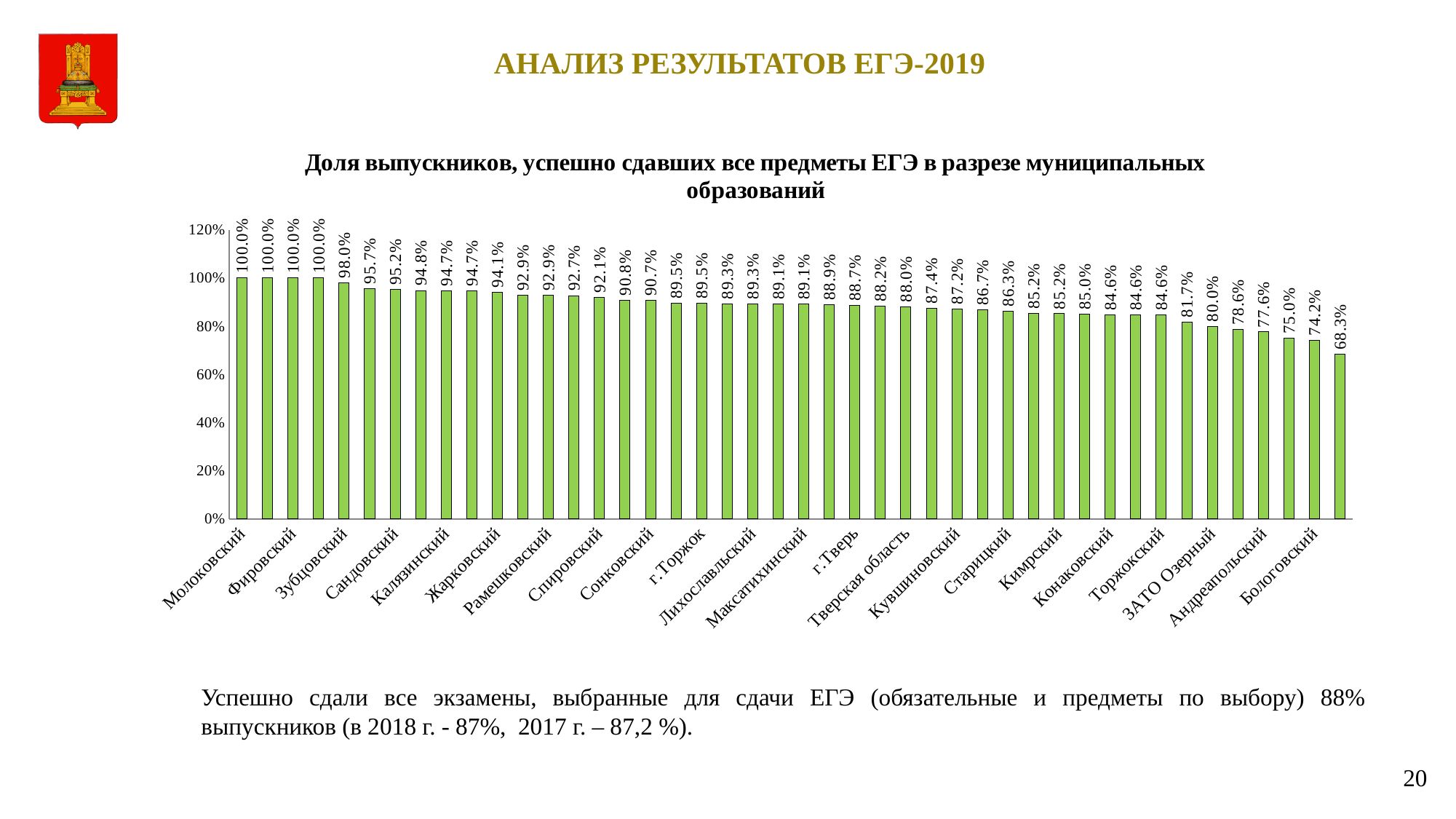
What is the difference between the highest value (100.0%) and the lowest value (68.3%)? 31.7 percentage points What is the title of the chart? Доля выпускников, успешно сдавших все предметы ЕГЭ в разрезе муниципальных образований Is the value for Тверская область greater or less than 80%? greater Do the values rise or fall from left to right along the x axis? Fall What is the highest value shown on the chart? 100.0% What type of chart is shown on the slide? Bar chart What is the lowest value shown on the chart? 68.3% Is the value for Андреапольский greater or less than 80%? less How many bars reach 100.0%? 4 What is the value for Молоковский? 100.0% Which has a larger value, Молоковский or Бологовский? Молоковский Is the value for Бологовский greater or less than 80%? less